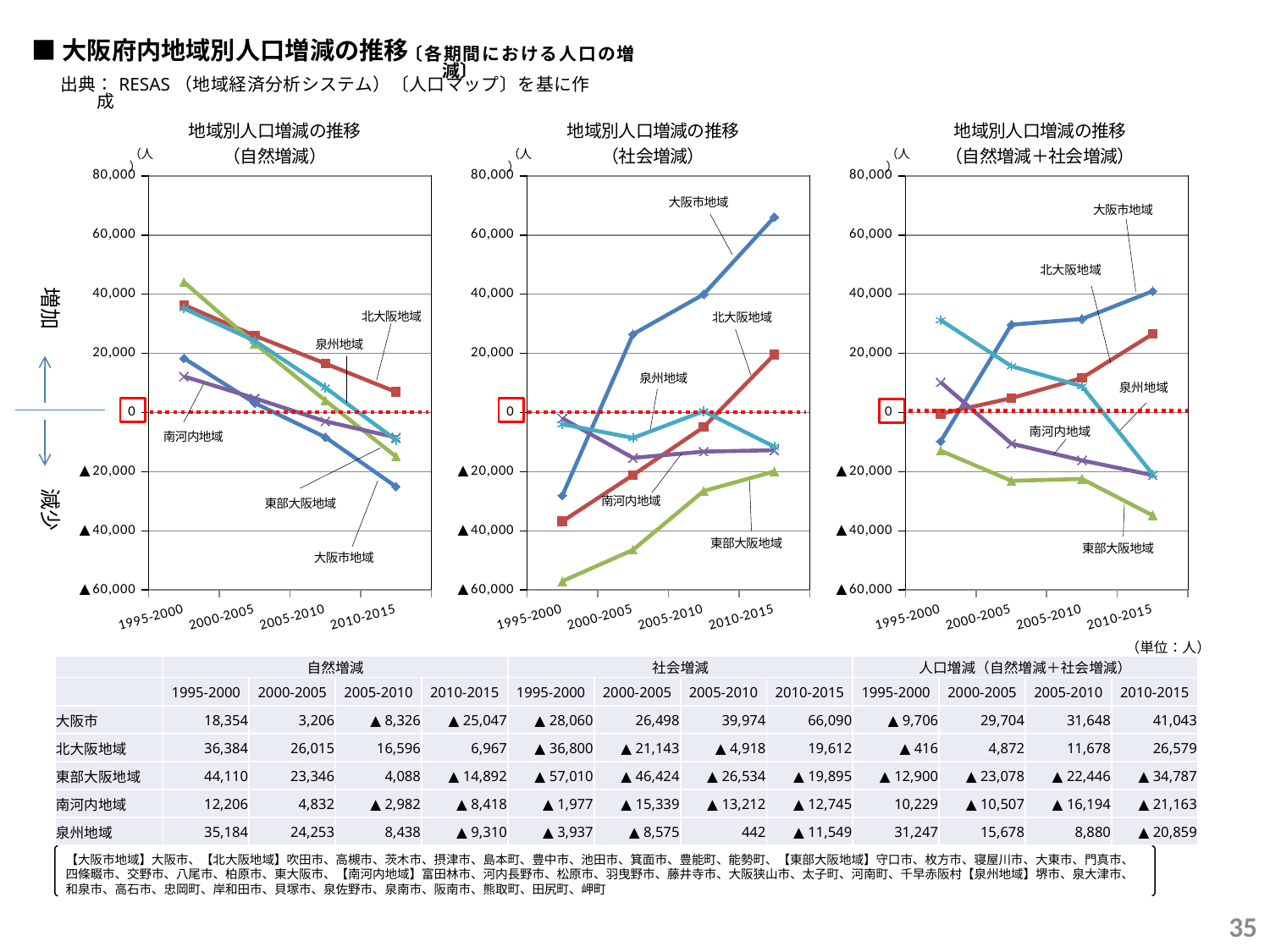
In the left chart (自然増減), which region has the lowest value in 2010-2015? 大阪市地域 In the middle chart (社会増減), which region has the highest value in 2010-2015? 大阪市地域 In the middle chart (社会増減), does the value for 大阪市地域 rise or fall from 1995-2000 to 2010-2015? rise How many regional series are plotted in the right chart (自然増減＋社会増減)? 5 In the middle chart (社会増減), is the value for 東部大阪地域 in 1995-2000 greater or less than ▲40,000? less In the left chart (自然増減), what is the value for 北大阪地域 in 1995-2000? 36,384 How many periods are shown on the x axis of the middle chart (社会増減)? 4 In the right chart (自然増減＋社会増減), what is the value for 東部大阪地域 in 2010-2015? ▲34,787 What kind of chart is the left chart titled 地域別人口増減の推移（自然増減）? line chart In the left chart (自然増減), what is the difference between the 北大阪地域 values for 1995-2000 and 2010-2015? 29,417 In the right chart (自然増減＋社会増減), which is larger in 2010-2015: 大阪市地域 or 北大阪地域? 大阪市地域 In the middle chart (社会増減), what is the value for 大阪市地域 in 2010-2015? 66,090